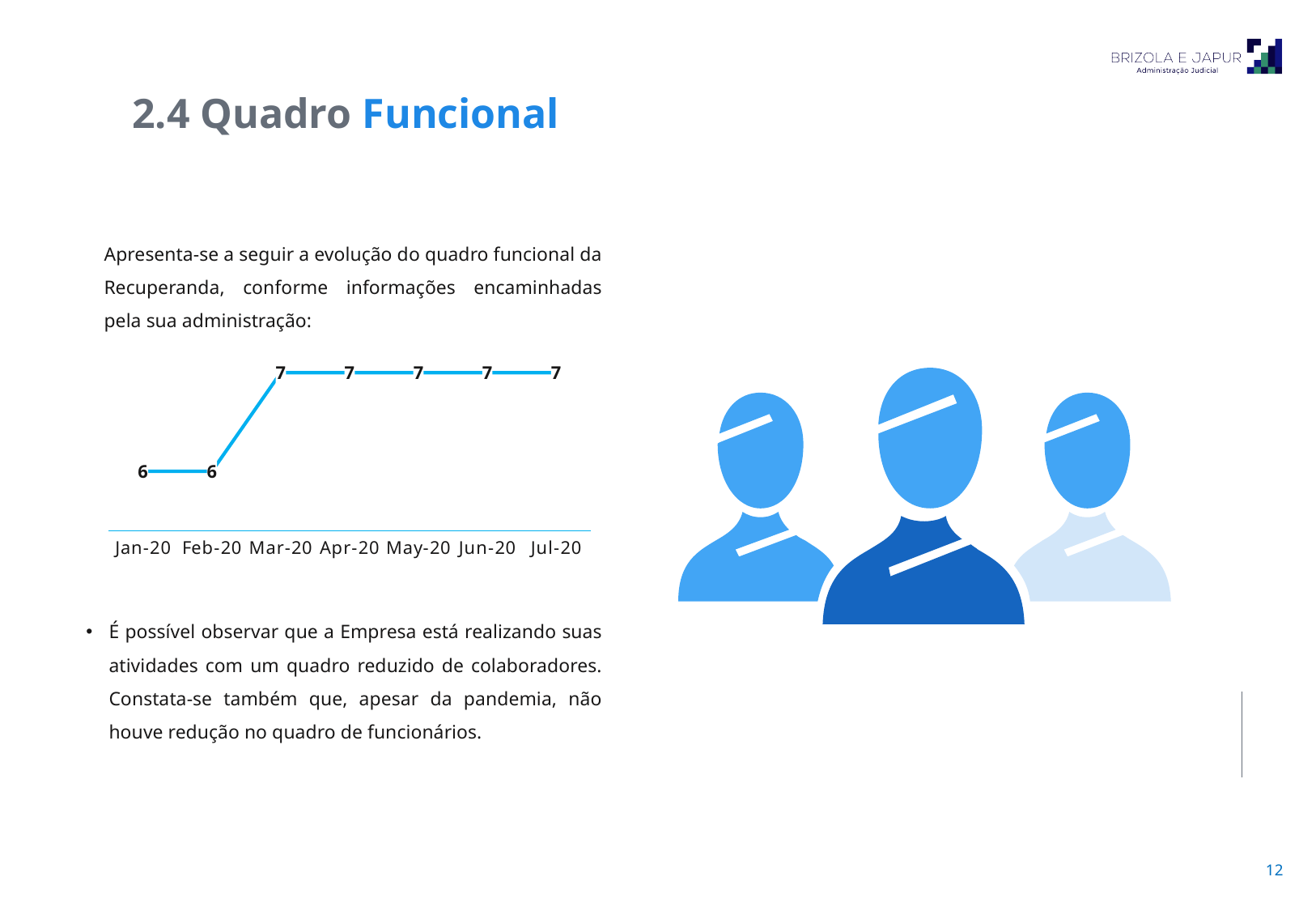
What is the value for Jul-20? 7 What kind of chart is shown on the slide? line chart What is the value for Mar-20? 7 What is the first month shown on the x axis? Jan-20 Which is larger, the value for Jan-20 or the value for Apr-20? Apr-20 What is the lowest value shown in the chart? 6 What is the highest value shown in the chart? 7 How many months are plotted on the x axis? 7 Do the values rise or fall from Feb-20 to Mar-20? rise What is the value for Feb-20? 6 What is the value for Jan-20? 6 What is the difference between the values for Mar-20 and Feb-20? 1